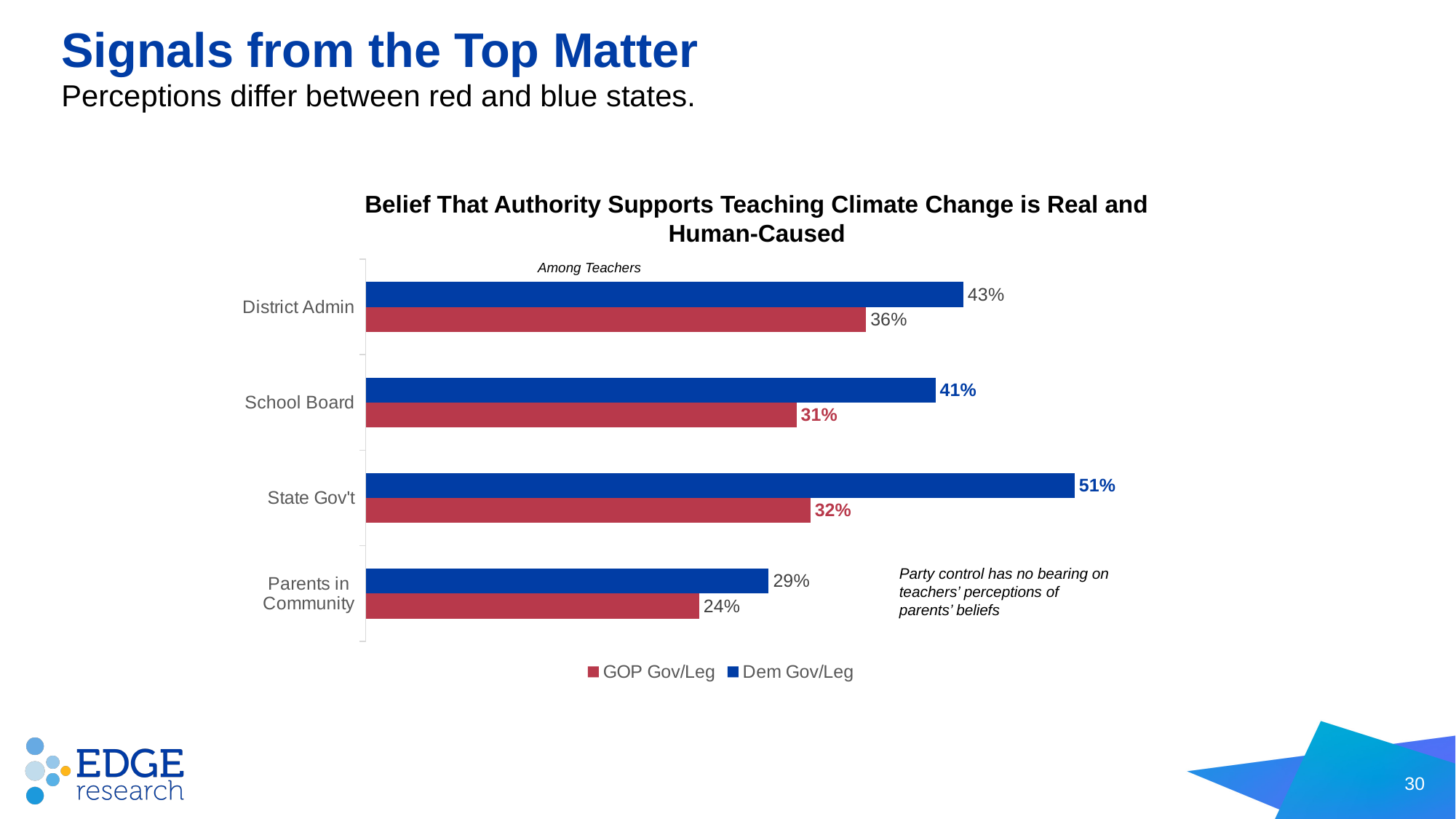
What is the GOP Gov/Leg value for District Admin? 36% What is the difference between the Dem Gov/Leg and GOP Gov/Leg values for State Gov't? 19% What kind of chart is shown on the slide? Bar chart What is the Dem Gov/Leg value for School Board? 41% Which category has the highest Dem Gov/Leg value? State Gov't What is the Dem Gov/Leg value for State Gov't? 51% How many categories are shown on the chart? 4 Which is larger for School Board: the GOP Gov/Leg value or the Dem Gov/Leg value? Dem Gov/Leg What is the GOP Gov/Leg value for Parents in Community? 24% What is the title of the chart? Belief That Authority Supports Teaching Climate Change is Real and Human-Caused How many series does the legend list? 2 Which category has the lowest GOP Gov/Leg value? Parents in Community